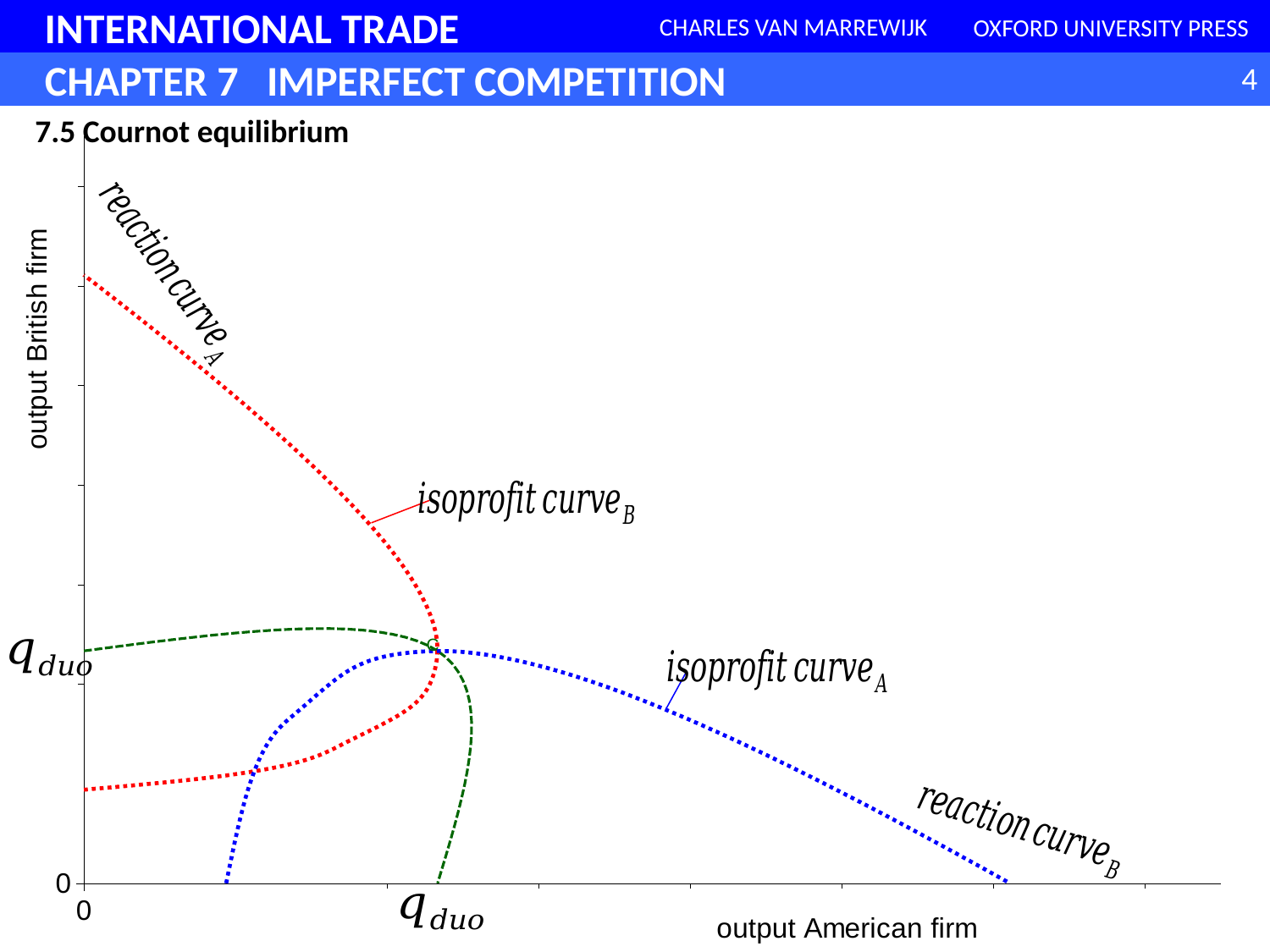
What is the label of the vertical axis of the chart? output British firm What is the label of the horizontal axis of the chart? output American firm What label marks the equilibrium output on the horizontal axis? q_duo What kind of chart is shown on the slide? line chart How many differently coloured curves are plotted in the chart? 3 What value is printed at the origin of the chart's axes? 0